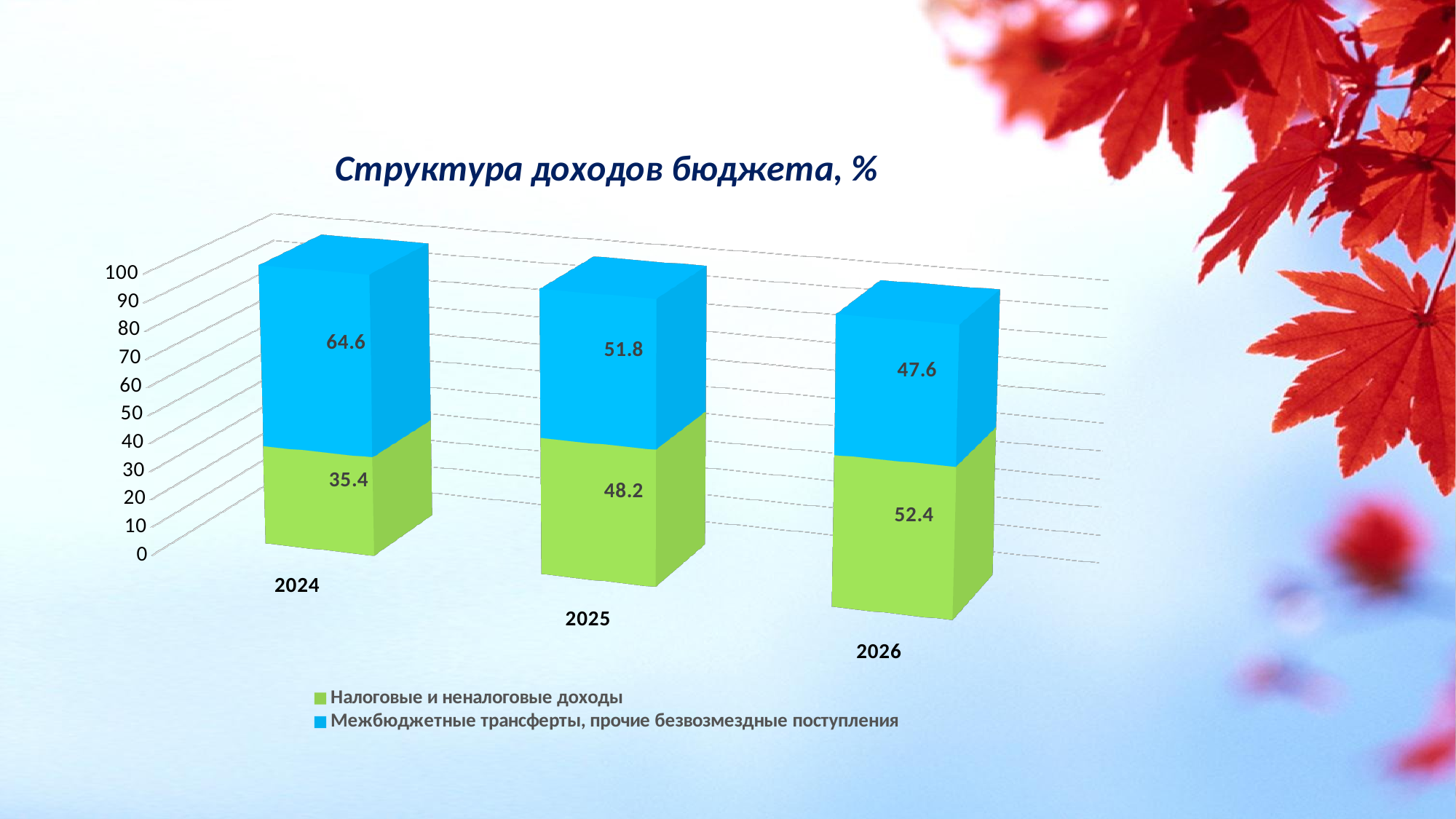
How many years are shown on the x axis? 3 How many series does the legend list? 2 In 2025, which is larger: Налоговые и неналоговые доходы or Межбюджетные трансферты, прочие безвозмездные поступления? Межбюджетные трансферты, прочие безвозмездные поступления What is the value for Межбюджетные трансферты, прочие безвозмездные поступления in 2025? 51.8 In which year is the value for Налоговые и неналоговые доходы the highest? 2026 What kind of chart is shown on the slide? Stacked bar chart Does the value for Налоговые и неналоговые доходы rise or fall from 2024 to 2026? Rise What is the value for Налоговые и неналоговые доходы in 2026? 52.4 What is the difference between the Межбюджетные трансферты value and the Налоговые и неналоговые доходы value in 2024? 29.2 What is the value for Налоговые и неналоговые доходы in 2024? 35.4 In which year is the value for Межбюджетные трансферты, прочие безвозмездные поступления the lowest? 2026 What is the value for Межбюджетные трансферты, прочие безвозмездные поступления in 2024? 64.6